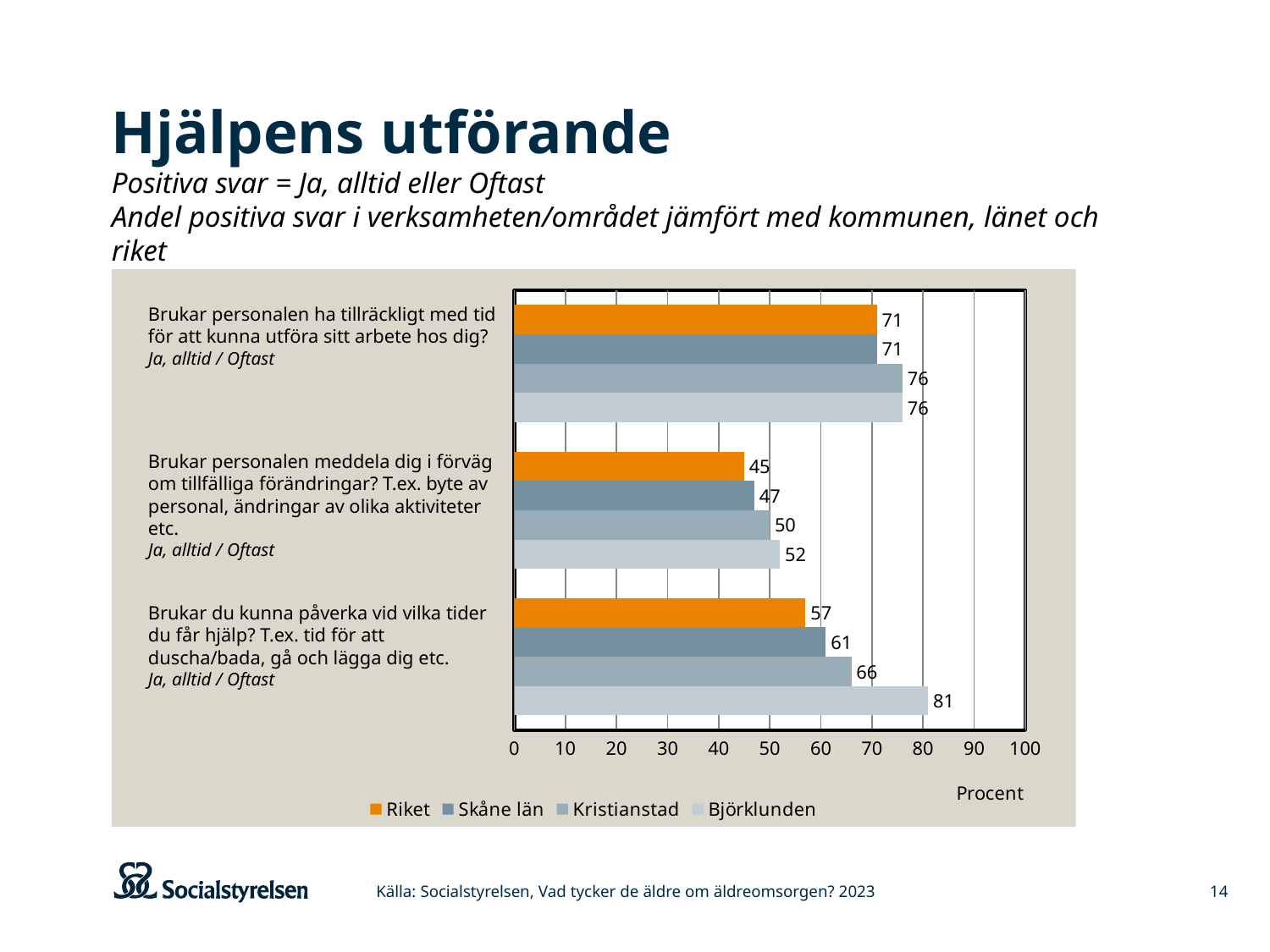
What is the value for Kristianstad for the question 'Brukar personalen ha tillräckligt med tid för att kunna utföra sitt arbete hos dig?' 76 What unit label is shown below the x axis of the chart? Procent What is the difference between Kristianstad and Skåne län for the question 'Brukar personalen ha tillräckligt med tid för att kunna utföra sitt arbete hos dig?' 5 What is the difference between Björklunden and Riket for the question 'Brukar du kunna påverka vid vilka tider du får hjälp?' 24 Which is larger for the question 'Brukar personalen meddela dig i förväg om tillfälliga förändringar?': Skåne län or Björklunden? Björklunden What is the value for Riket for the question 'Brukar personalen meddela dig i förväg om tillfälliga förändringar?' 45 What is the value for Björklunden for the question 'Brukar du kunna påverka vid vilka tider du får hjälp?' 81 How many series does the legend list? 4 How many question categories are plotted on the chart? 3 Which series has the lowest value for the question 'Brukar personalen meddela dig i förväg om tillfälliga förändringar?' Riket Which series has the highest value for the question 'Brukar du kunna påverka vid vilka tider du får hjälp?' Björklunden What kind of chart is shown on the slide? Bar chart